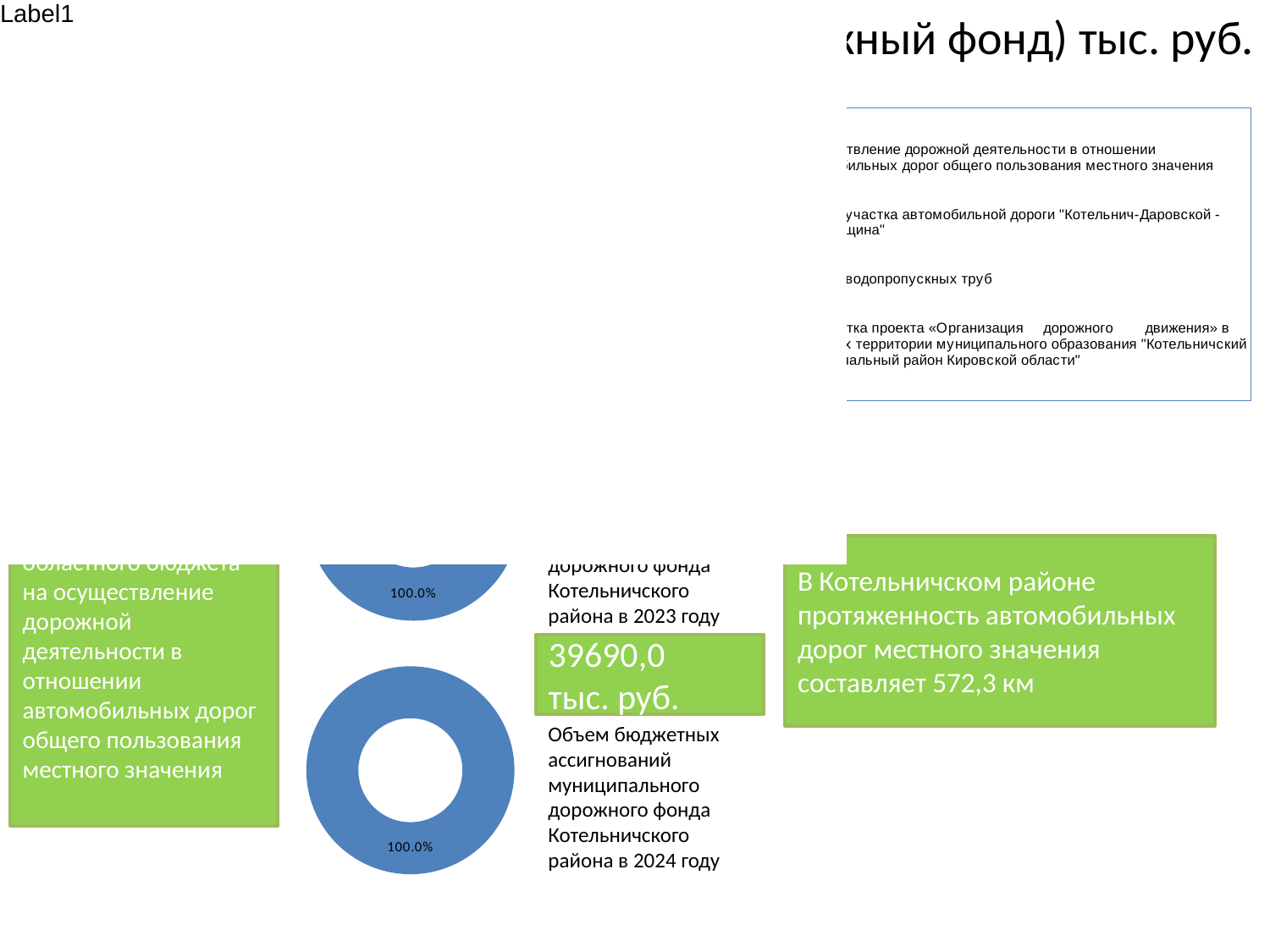
How many slices does the lower doughnut chart contain? 1 What colour is the slice in the lower doughnut chart? blue In the lower doughnut chart, what share is shown by the data label on the single slice? 100.0% What kind of chart is the lower chart on the left side of the slide? doughnut chart What data label is printed on the partially visible upper doughnut chart? 100.0% How many doughnut charts are visible on the slide? 2